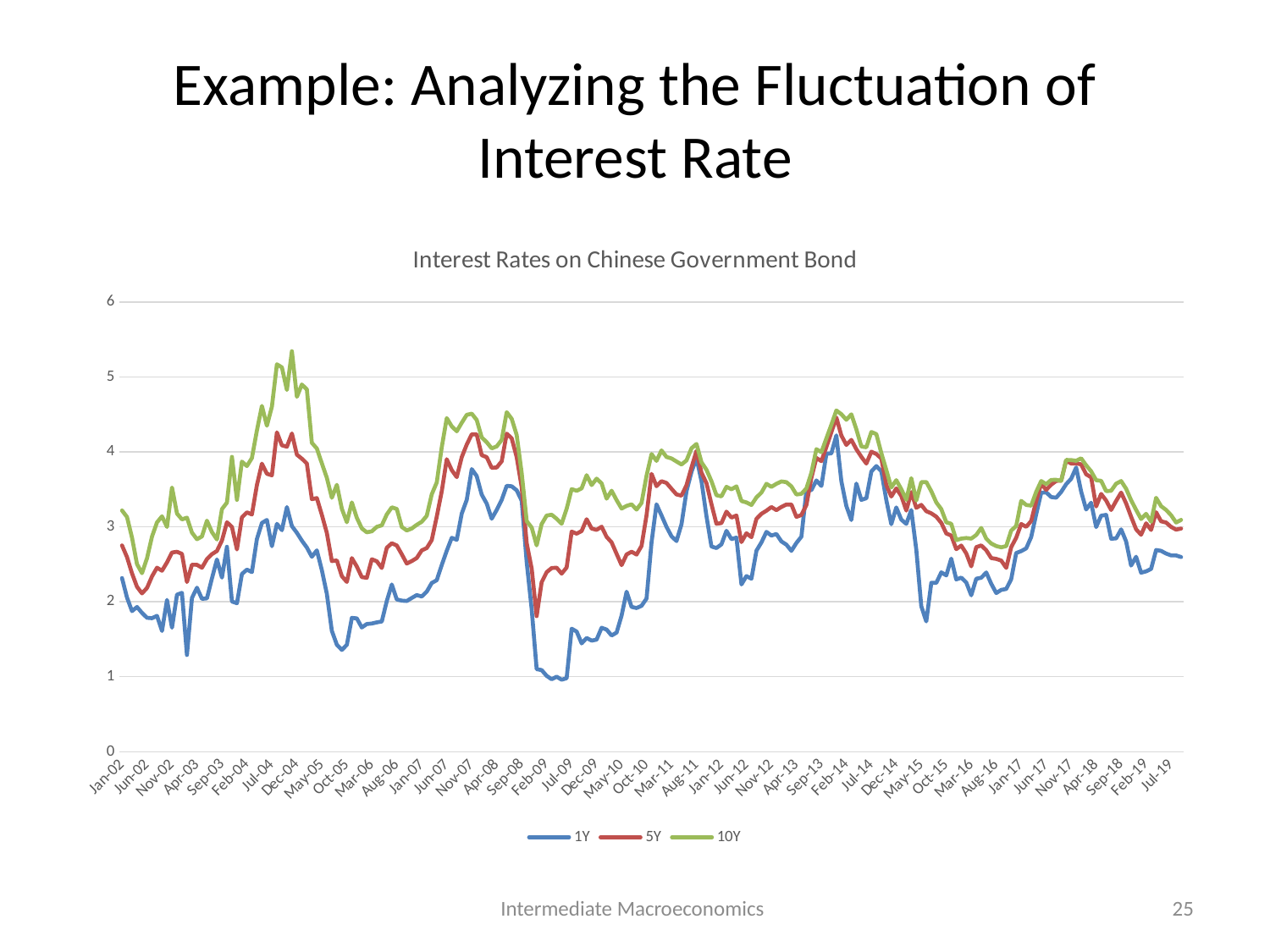
Does the 1Y series rise or fall between Feb-14 and May-15? fall Is the peak value of the 10Y series around Dec-04 greater or less than 5? greater What kind of chart is shown on the slide? line chart Is the value of the 10Y series around Feb-14 greater or less than 4? greater How many series does the legend list? 3 Is the value of the 1Y series around Feb-09 greater or less than 2? less Which series reaches the highest value on the chart? 10Y At Jan-02, which series has the higher value, 1Y or 10Y? 10Y Which series is drawn in green? 10Y Which series reaches the lowest value on the chart? 1Y What is the title of the chart? Interest Rates on Chinese Government Bond